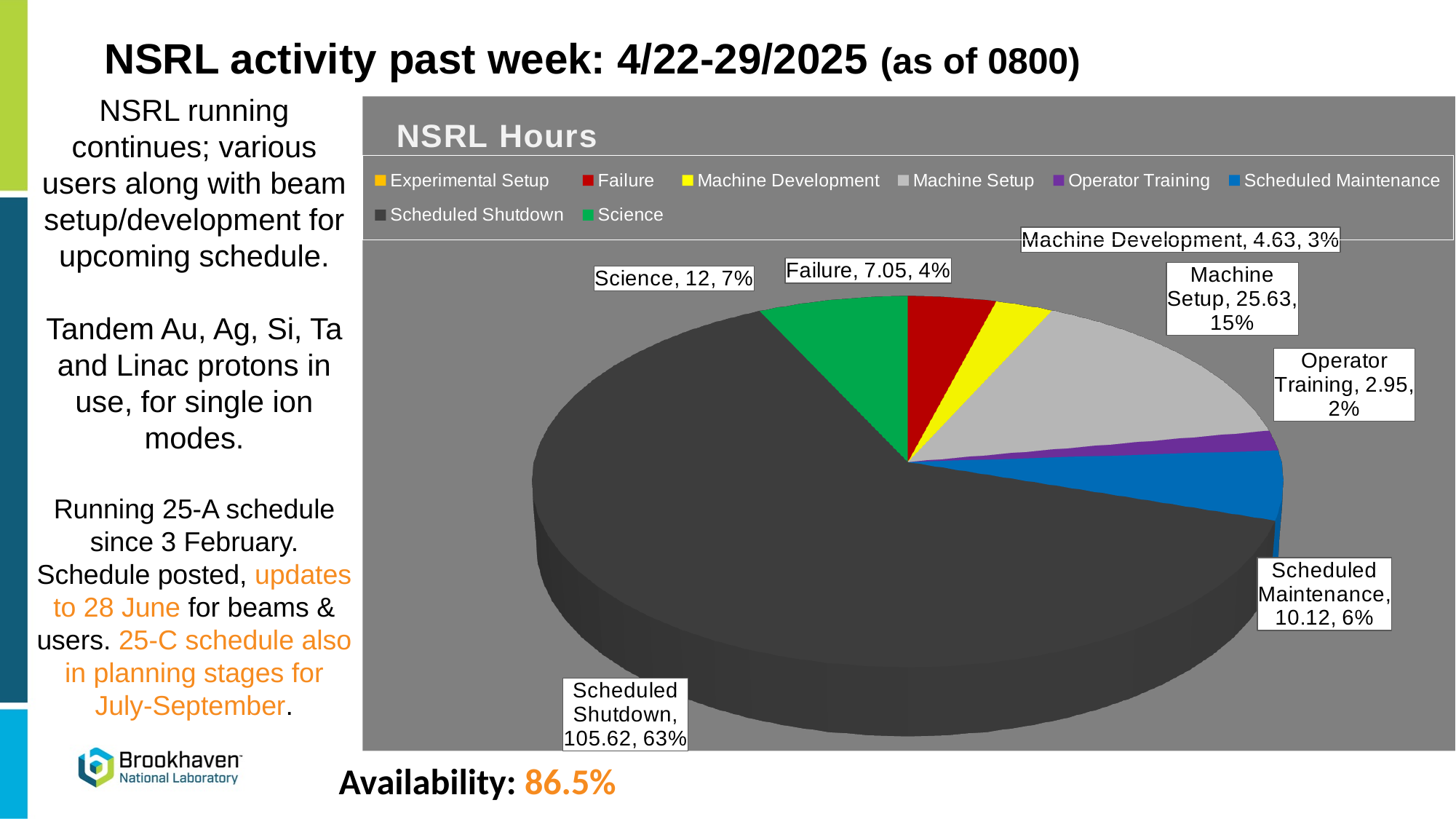
What colour is the Science slice? Green Which is larger, Scheduled Maintenance or Machine Development? Scheduled Maintenance What share of the pie does Science represent? 7% How many hours are shown for Scheduled Shutdown? 105.62 How many series does the legend list? 8 Which labeled category has the smallest slice? Operator Training Which category has the largest slice? Scheduled Shutdown What is the difference in hours between Machine Setup and Scheduled Maintenance? 15.51 What share of the pie does Machine Setup represent? 15% What type of chart is shown on the slide? Pie chart What is the title of the chart? NSRL Hours How many hours are shown for Failure? 7.05